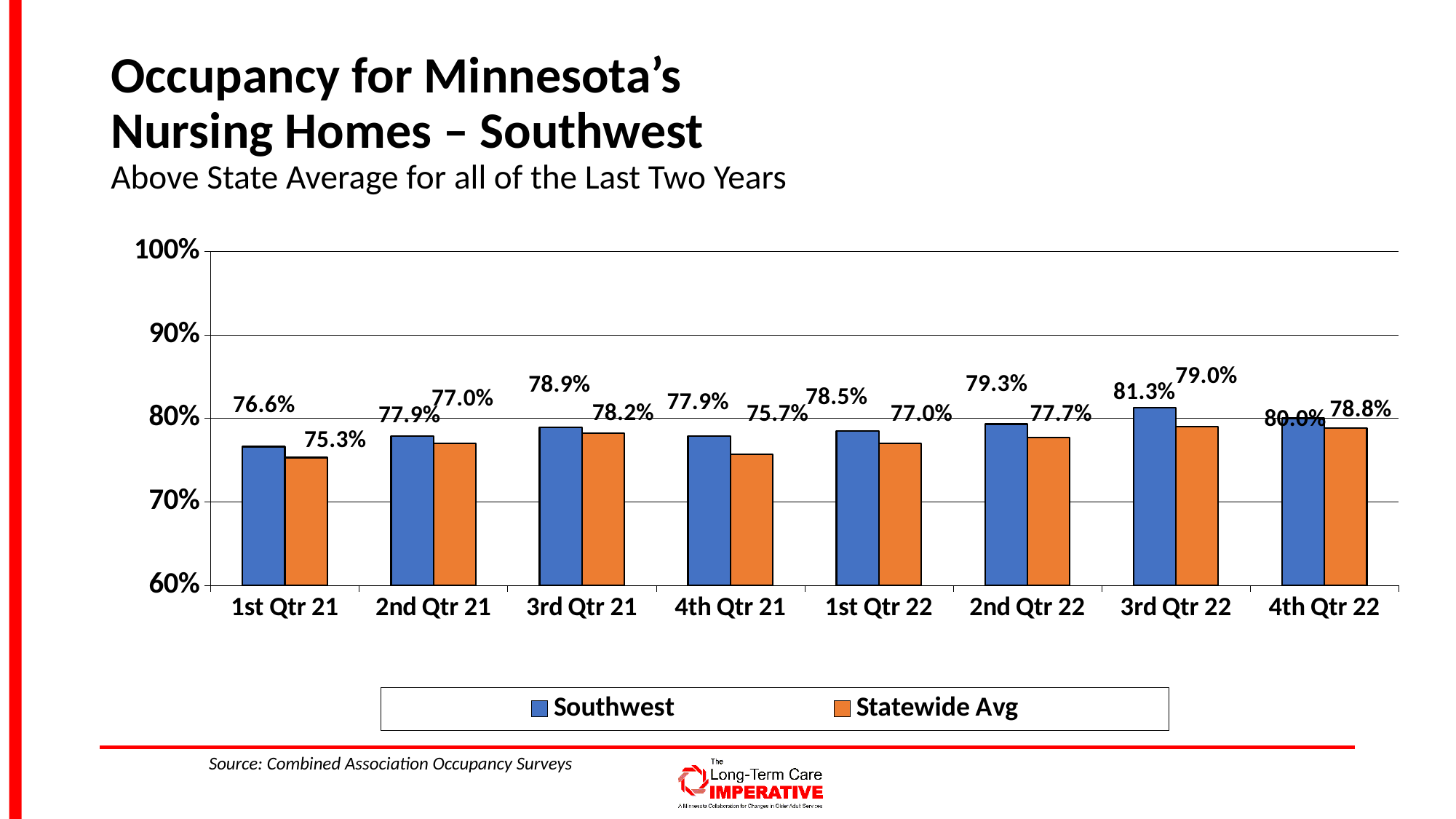
What is the Statewide Avg occupancy value for 1st Qtr 21? 75.3% What is the Southwest occupancy value for 3rd Qtr 22? 81.3% In which quarter is the Statewide Avg occupancy lowest? 1st Qtr 21 How many series does the legend list? 2 What is the Statewide Avg value for 4th Qtr 21? 75.7% What is the difference between the Southwest and Statewide Avg values in 4th Qtr 21? 2.2% Which is larger in 4th Qtr 22, the Southwest value or the Statewide Avg value? Southwest How many quarters are shown on the x axis? 8 Which colour represents the Statewide Avg series? Orange In which quarter is the Southwest occupancy highest? 3rd Qtr 22 What kind of chart is shown on the slide? Bar chart What is the Southwest value for 2nd Qtr 22? 79.3%